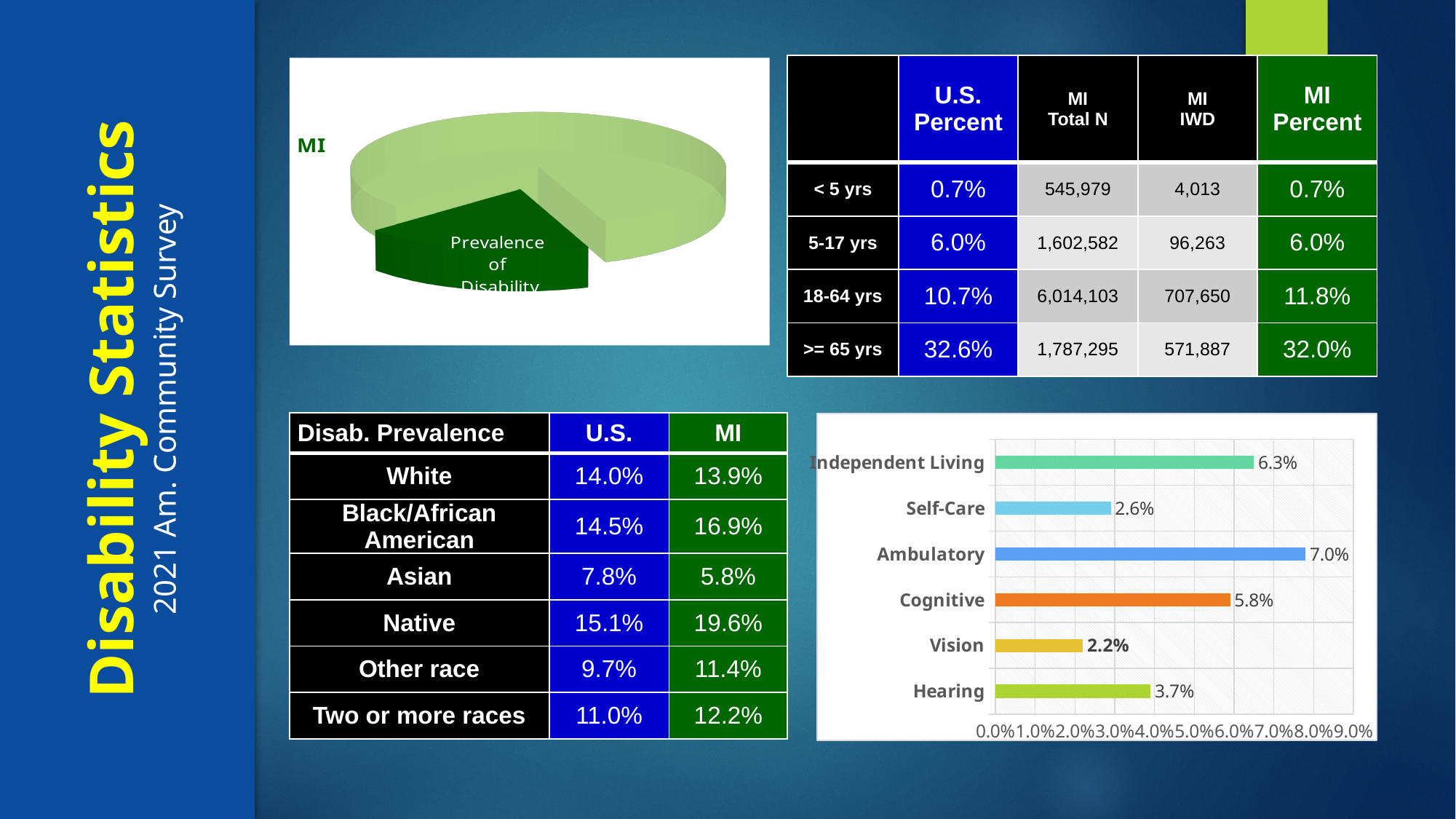
In the bar chart at the bottom right, what is the value for Independent Living? 6.3% In the bar chart at the bottom right, which is larger, the value for Cognitive or the value for Hearing? Cognitive In the bar chart at the bottom right, what is the difference between the values for Ambulatory and Self-Care? 4.4% In the bar chart at the bottom right, what is the value for Hearing? 3.7% In the bar chart at the bottom right, what is the value for Ambulatory? 7.0% How many categories are shown in the bar chart at the bottom right? 6 What kind of chart is shown at the top left of the slide? pie chart What kind of chart is shown at the bottom right of the slide? bar chart In the bar chart at the bottom right, which category has the lowest value? Vision In the bar chart at the bottom right, which category has the highest value? Ambulatory In the pie chart at the top left, what is the label on the dark green slice? Prevalence of Disability In the bar chart at the bottom right, is the value for Independent Living greater or less than 5.0%? greater